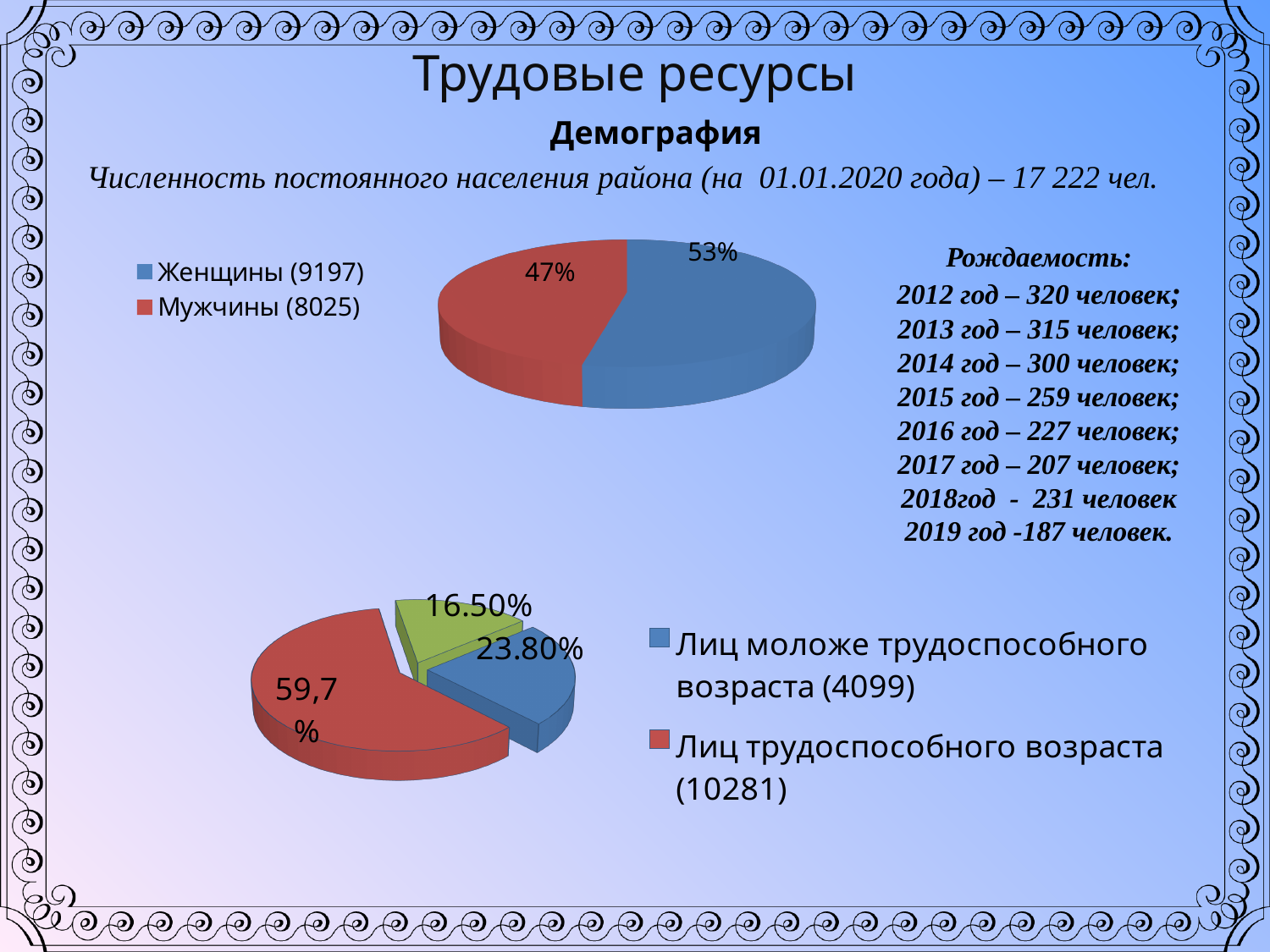
In the bottom pie chart, which slice is the largest? Лиц трудоспособного возраста In the bottom pie chart, what share is shown for Лиц моложе трудоспособного возраста? 23.80% How many series does the legend of the top pie chart list? 2 In the bottom pie chart, what colour is the slice for Лиц трудоспособного возраста? Red In the bottom pie chart, what share is shown for Лиц трудоспособного возраста? 59,7% In the top pie chart, what number is shown in the legend for Женщины? 9197 What type of chart is the top chart on the slide? Pie chart In the top pie chart, what share of the population is Мужчины? 47% In the top pie chart, what is the difference in percentage points between the Женщины and Мужчины shares? 6% In the top pie chart, which group has the larger share, Женщины or Мужчины? Женщины How many slices does the bottom pie chart have? 3